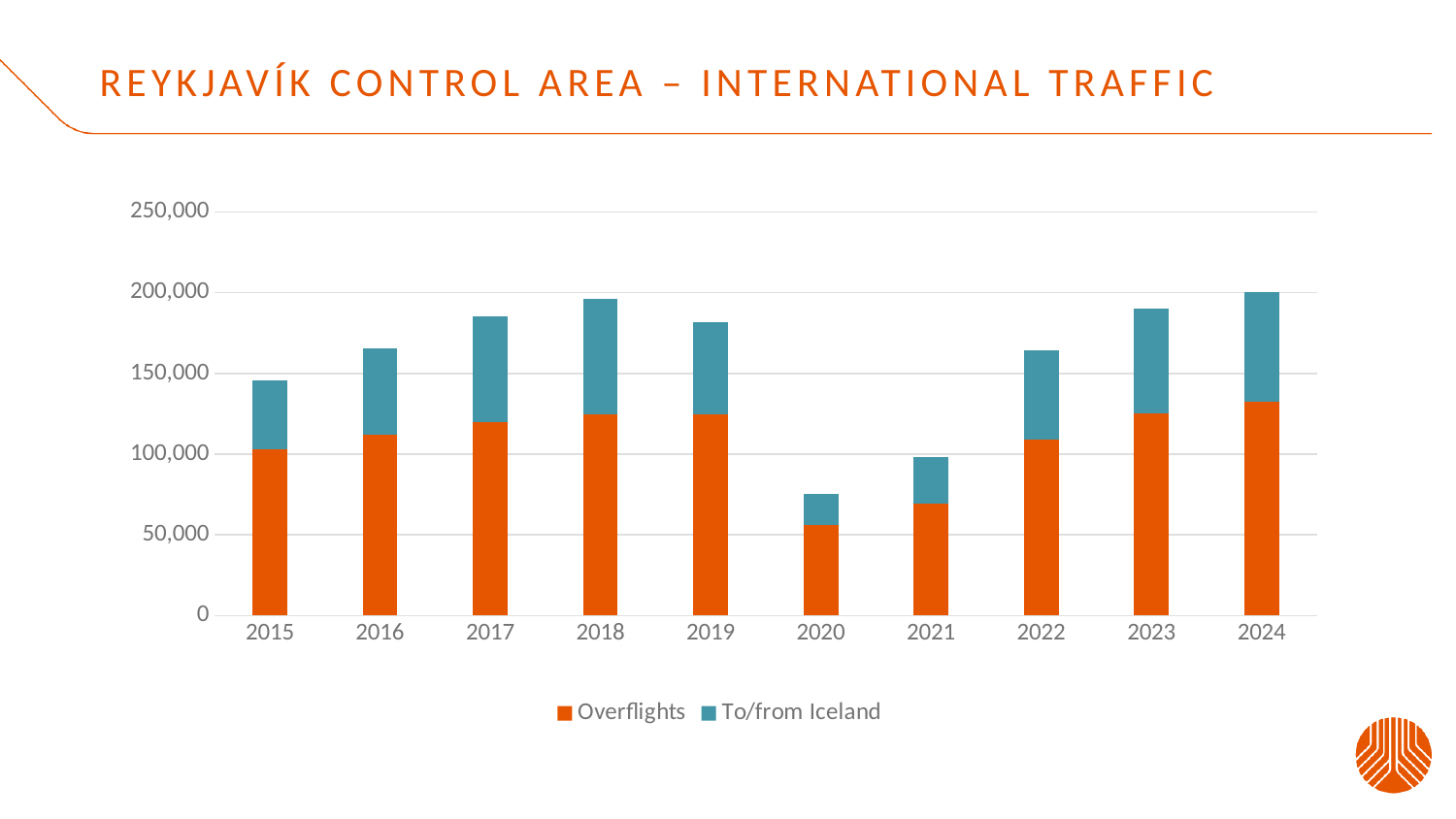
What kind of chart is shown on the slide? Stacked bar chart How many series does the chart's legend list? 2 Is the total traffic for 2024 greater or less than 150,000? greater Is the total traffic for 2019 greater or less than 200,000? less Which year has the lowest total international traffic? 2020 Is the Overflights value for 2020 greater or less than 50,000? greater Which series is shown in orange in the chart? Overflights How many years are shown on the x axis of the chart? 10 Which year has the highest total international traffic? 2024 Do the total traffic values rise or fall from 2015 to 2018? rise